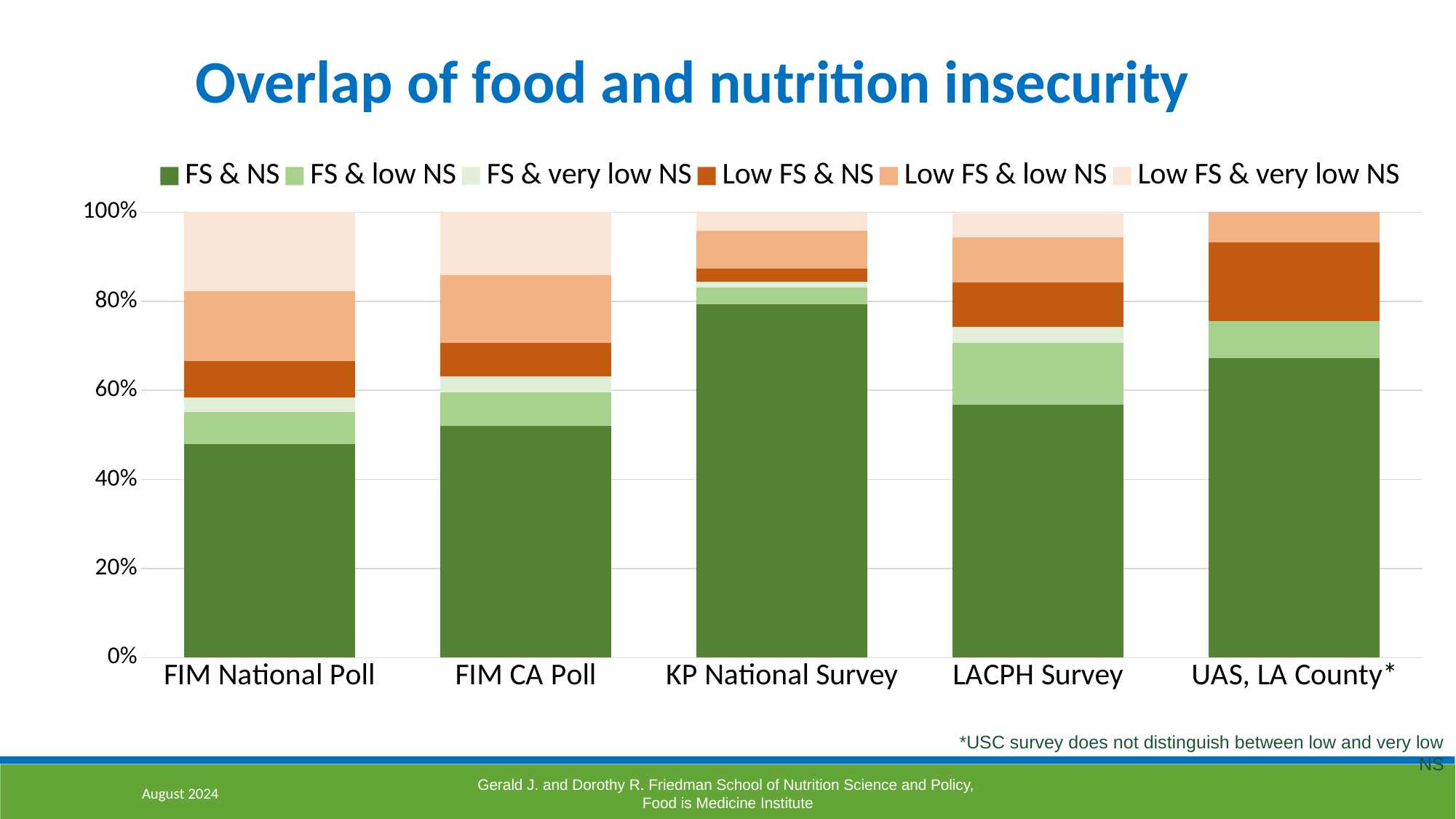
Is the FS & NS value for UAS, LA County* greater or less than 60%? greater Which has a larger Low FS & very low NS segment, FIM National Poll or KP National Survey? FIM National Poll Which has a larger FS & NS segment, LACPH Survey or FIM National Poll? LACPH Survey Which survey has the largest Low FS & very low NS segment? FIM National Poll Is the FS & NS value for KP National Survey greater or less than 60%? greater Is the FS & NS value for FIM National Poll greater or less than 60%? less What kind of chart is shown on the slide? Stacked bar chart How many surveys (categories) are shown along the x axis? 5 How many series does the legend list? 6 Which survey has the largest FS & NS segment? KP National Survey What is the title of the chart? Overlap of food and nutrition insecurity Which survey has the largest Low FS & NS segment? UAS, LA County*